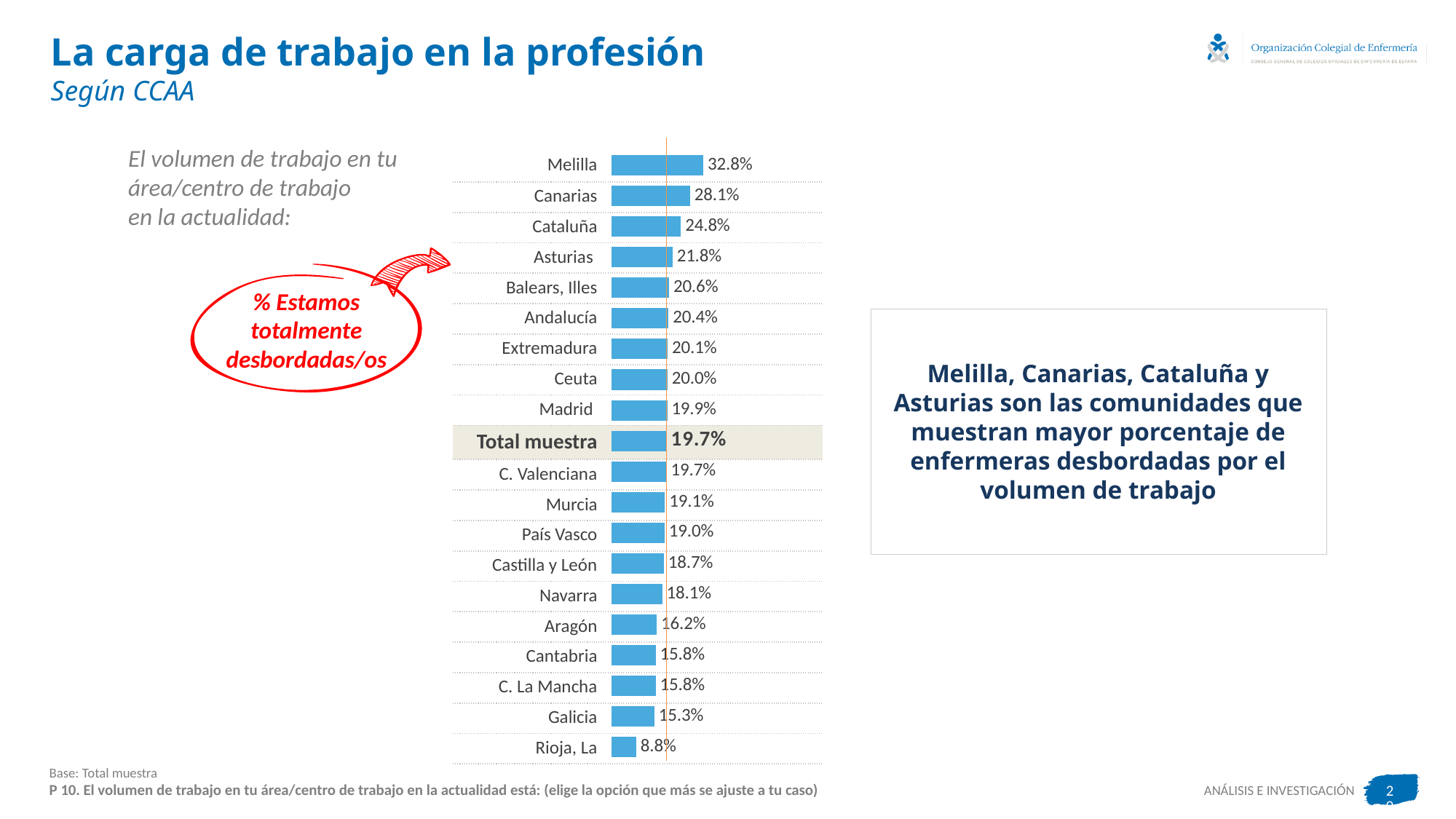
What kind of chart is shown on the slide? Bar chart Which category has the lowest value? Rioja, La What is the value for Melilla? 32.8% Which is larger, the value for Aragón or the value for Navarra? Navarra What is the difference between the values for Melilla and Canarias? 4.7% Which is larger, the value for Cataluña or the value for Asturias? Cataluña What is the difference between the values for Asturias and Rioja, La? 13.0% How many categories (bars) are shown in the chart? 20 What is the value for Extremadura? 20.1% What is the value for Total muestra? 19.7% What is the value for Galicia? 15.3% Which category has the highest value? Melilla